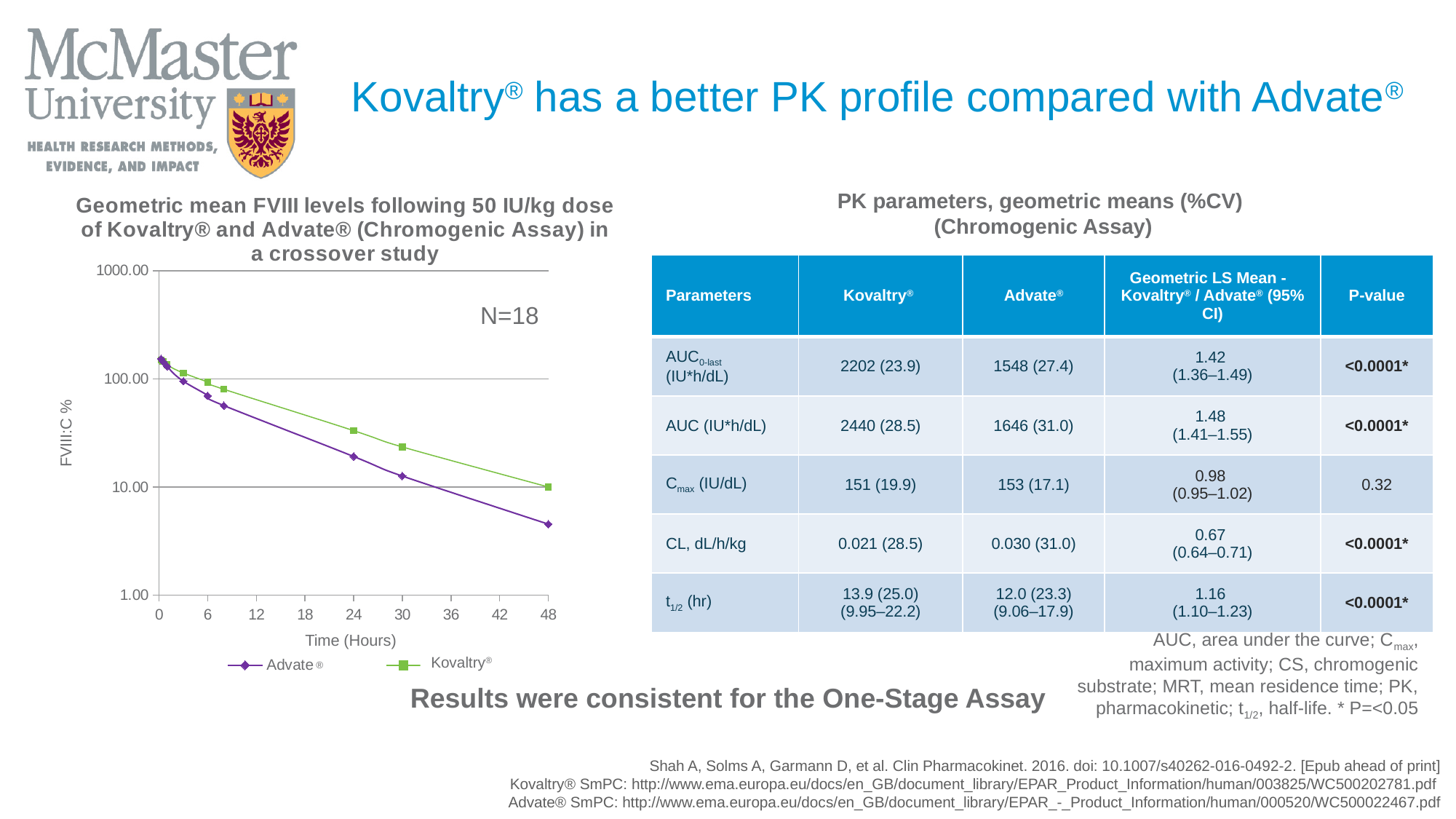
Do the FVIII:C % values rise or fall as time increases along the x axis? fall At 30 hours, which series has the lower FVIII:C % value, Advate or Kovaltry? Advate How many series does the chart legend list? 2 What is the title of the x axis of the chart? Time (Hours) What kind of chart is shown on the slide? line chart At 48 hours, which series has the higher FVIII:C % value, Advate or Kovaltry? Kovaltry Is the value for Advate at 48 hours greater or less than 10.00? less Is the value for Advate at 0 hours greater or less than 100.00? greater Is the value for Kovaltry at 24 hours greater or less than 10.00? greater What sample size (N) is annotated on the chart? N=18